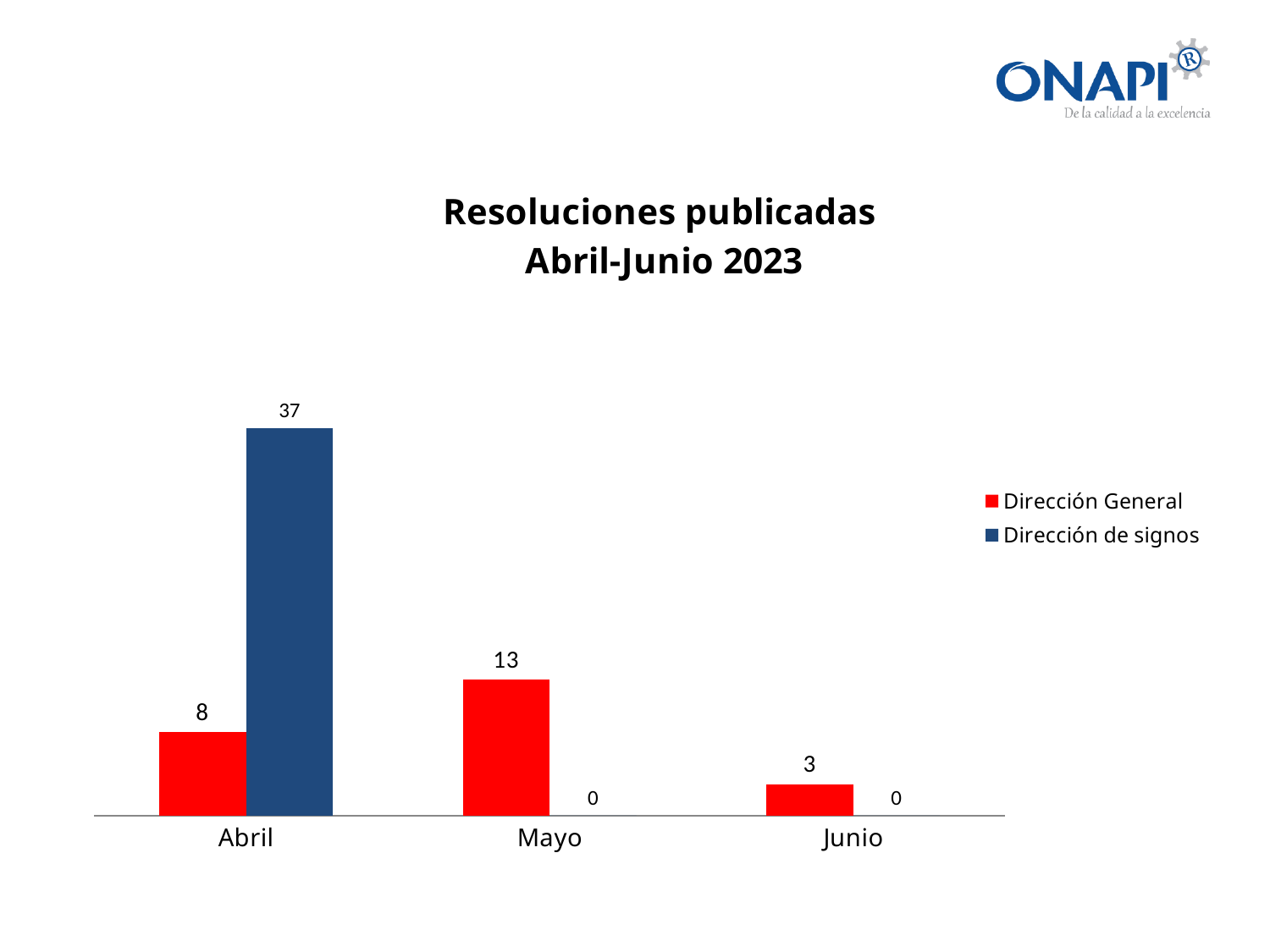
What is the value for Dirección General in Abril? 8 What is the value for Dirección General in Mayo? 13 How many series does the legend list? 2 Which month has the lowest value for Dirección General? Junio What kind of chart is shown on the slide? Bar chart What is the difference between Dirección de signos and Dirección General in Abril? 29 How many months are shown on the x axis? 3 What is the value for Dirección de signos in Junio? 0 Which is larger in Abril, Dirección General or Dirección de signos? Dirección de signos What is the value for Dirección de signos in Abril? 37 Which month has the highest value for Dirección General? Mayo What is the title of the chart? Resoluciones publicadas Abril-Junio 2023